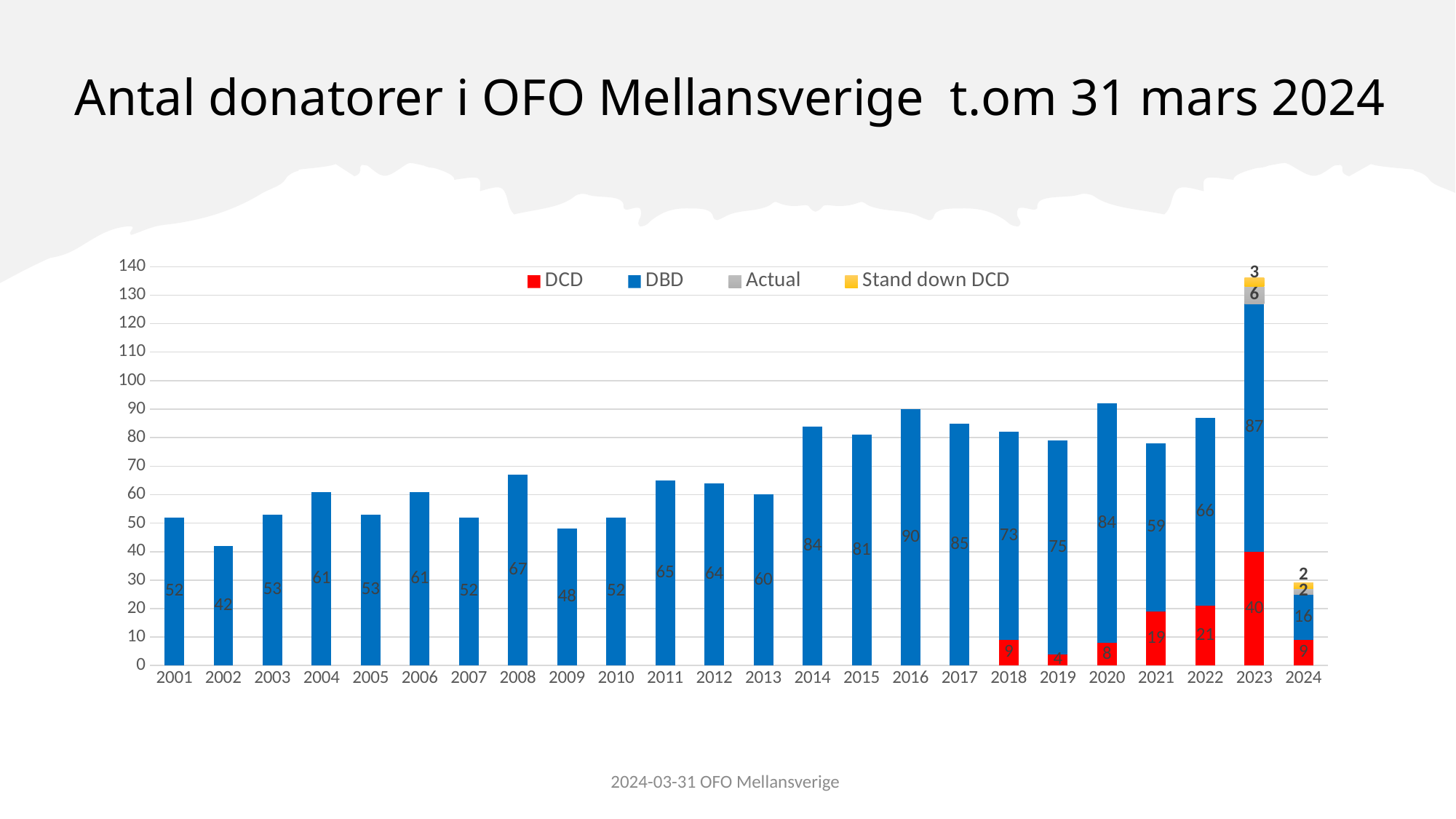
What is the Actual value for 2023? 6 What is the DBD value for 2016? 90 What is the difference between the DBD values for 2014 and 2013? 24 What is the total of the stacked bar for 2023? 136 Which year has the lowest DBD value? 2024 How many years are shown on the x axis? 24 What is the title of the slide? Antal donatorer i OFO Mellansverige t.om 31 mars 2024 Which year has the highest DBD value? 2016 What is the DCD value for 2022? 21 What kind of chart is shown on the slide? Stacked bar chart How many series does the legend list? 4 Which year has the larger DCD value, 2020 or 2021? 2021